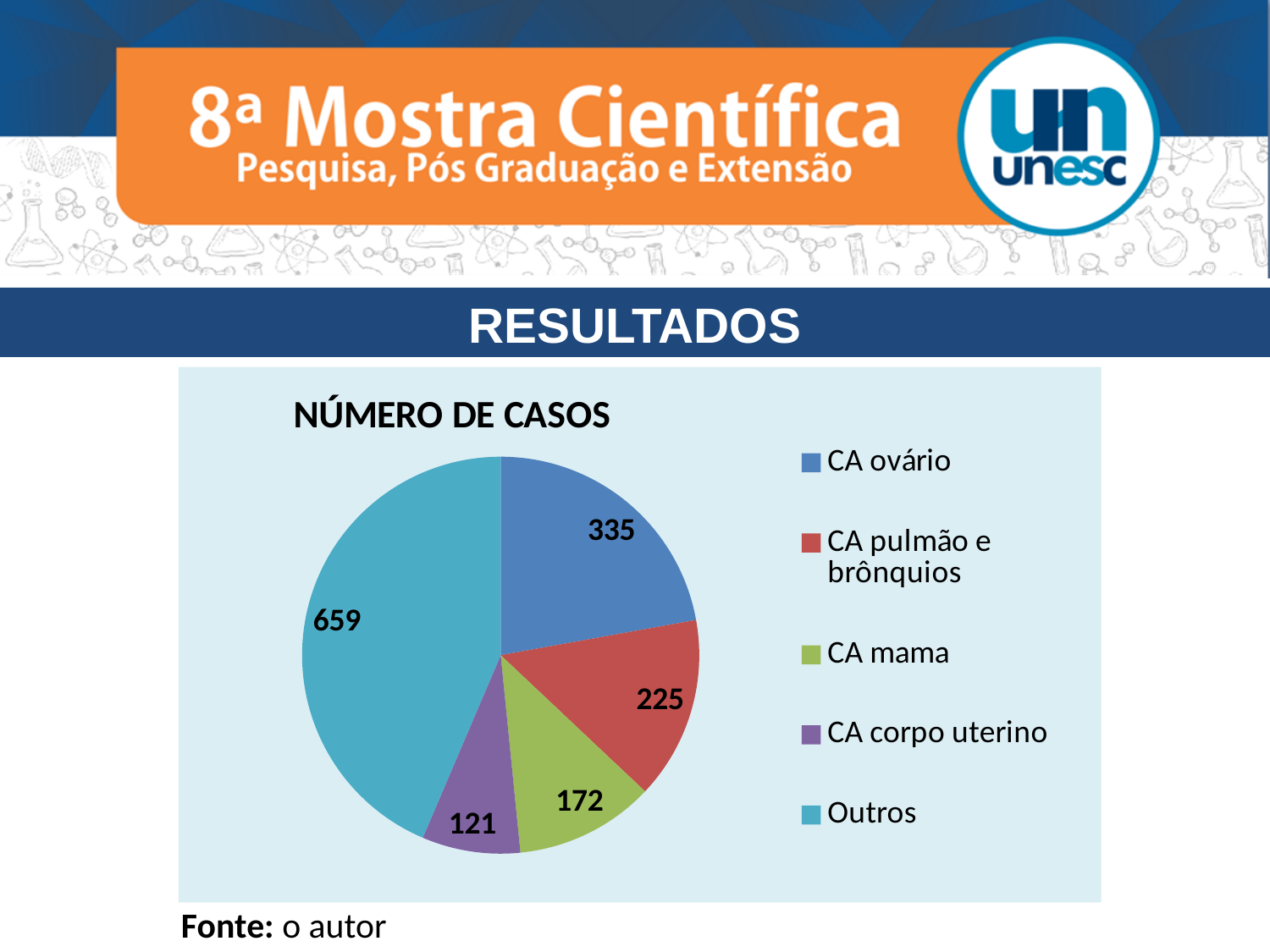
What is the number of cases for CA mama? 172 What kind of chart is shown on the slide? Pie chart What is the number of cases for CA pulmão e brônquios? 225 What is the number of cases for CA ovário? 335 What is the title of the chart? NÚMERO DE CASOS What is the number of cases for CA corpo uterino? 121 Which category has the smallest number of cases? CA corpo uterino Which category has the largest number of cases? Outros Which has more cases, CA pulmão e brônquios or CA mama? CA pulmão e brônquios How many categories are shown in the pie chart? 5 What is the difference in cases between Outros and CA ovário? 324 What is the total number of cases across all slices of the pie chart? 1512